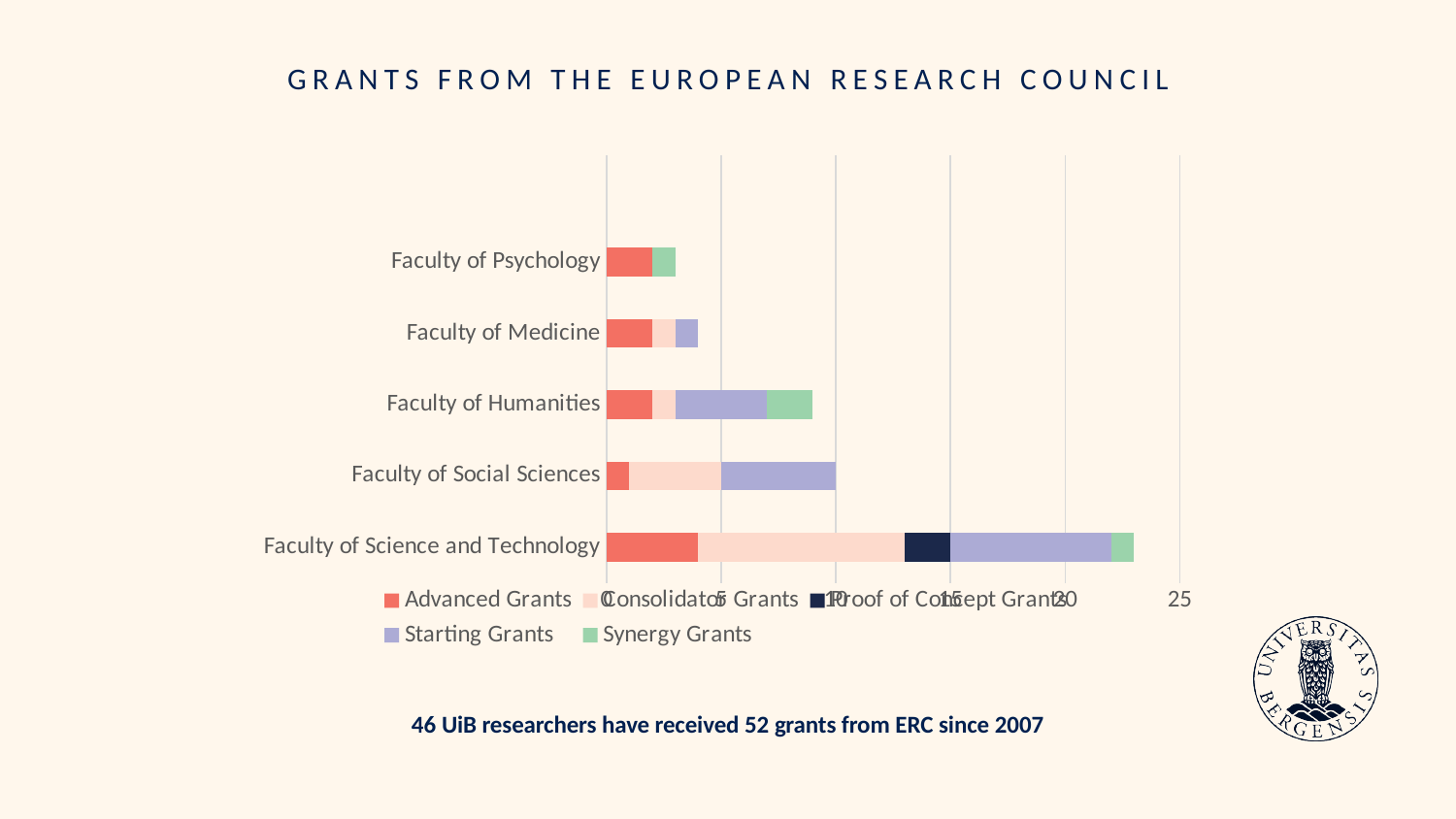
How many series does the legend list? 5 Is the total bar length for Faculty of Psychology greater or less than 5? less Is the total bar length for Faculty of Medicine greater or less than 5? less Which faculty has the longest bar in total? Faculty of Science and Technology Which faculty has the shortest bar in total? Faculty of Psychology Which series in the legend is shown in dark navy? Proof of Concept Grants What is the title of the chart? GRANTS FROM THE EUROPEAN RESEARCH COUNCIL How many faculties are shown on the chart? 5 Is the total bar length for Faculty of Science and Technology greater or less than 20? greater Which has the longer total bar, Faculty of Humanities or Faculty of Medicine? Faculty of Humanities What kind of chart is shown on the slide? Bar chart